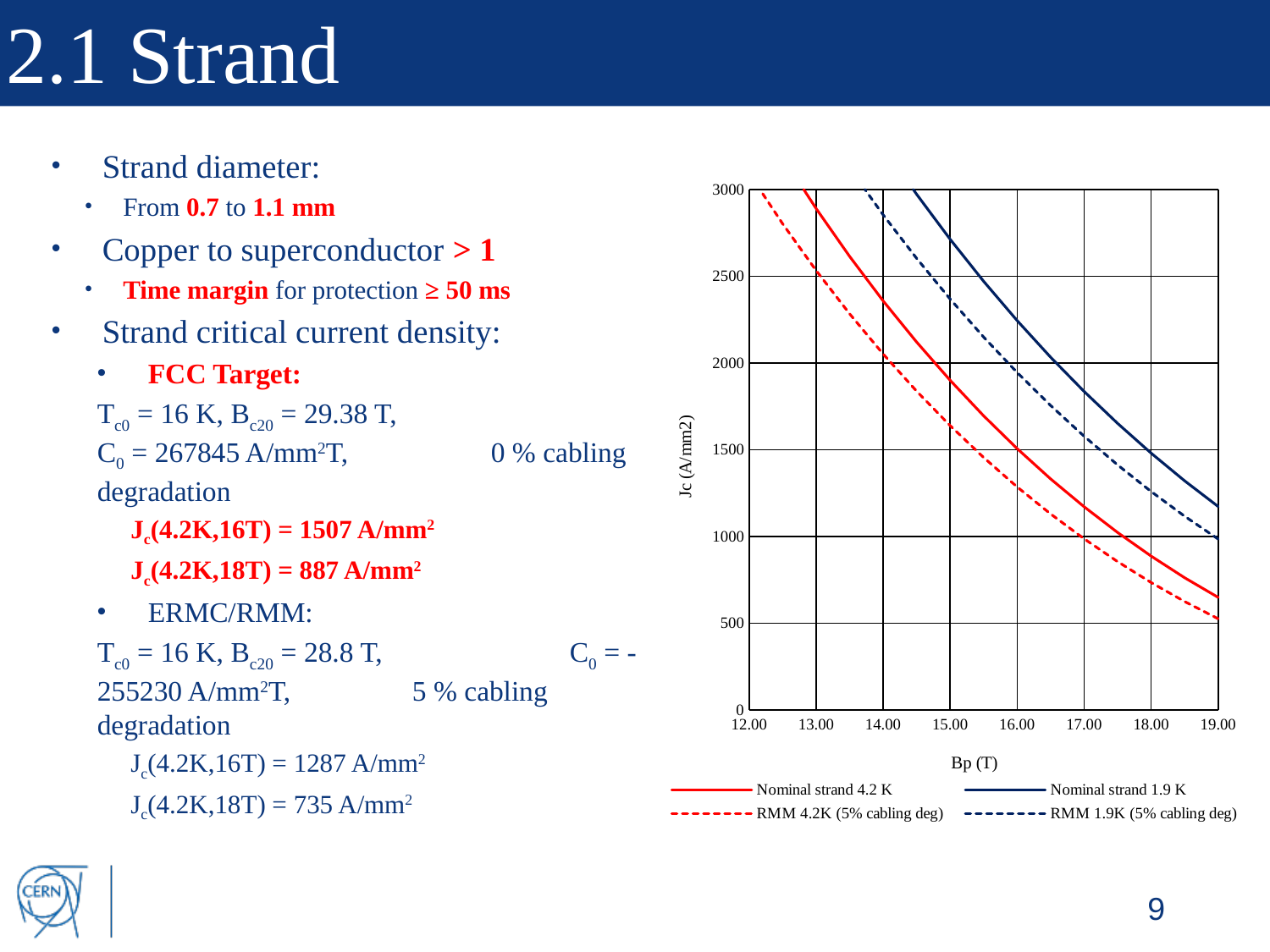
Which series has the highest Jc value at Bp = 19.00 T? Nominal strand 1.9 K Is the Jc value for RMM 4.2K (5% cabling deg) at Bp = 18.00 T greater or less than 1000? less What is the title of the y axis of the chart? Jc (A/mm2) At Bp = 16.00 T, which series has the larger Jc value, Nominal strand 1.9 K or Nominal strand 4.2 K? Nominal strand 1.9 K What kind of chart is shown on the slide? line chart Which series has the lowest Jc value at Bp = 19.00 T? RMM 4.2K (5% cabling deg) Is the Jc value for Nominal strand 1.9 K at Bp = 16.00 T greater or less than 2000? greater How many series does the chart legend list? 4 Is the Jc value for Nominal strand 4.2 K at Bp = 18.00 T greater or less than 1000? less What is the title of the x axis of the chart? Bp (T) Do the Jc values rise or fall as Bp increases along the x axis? fall